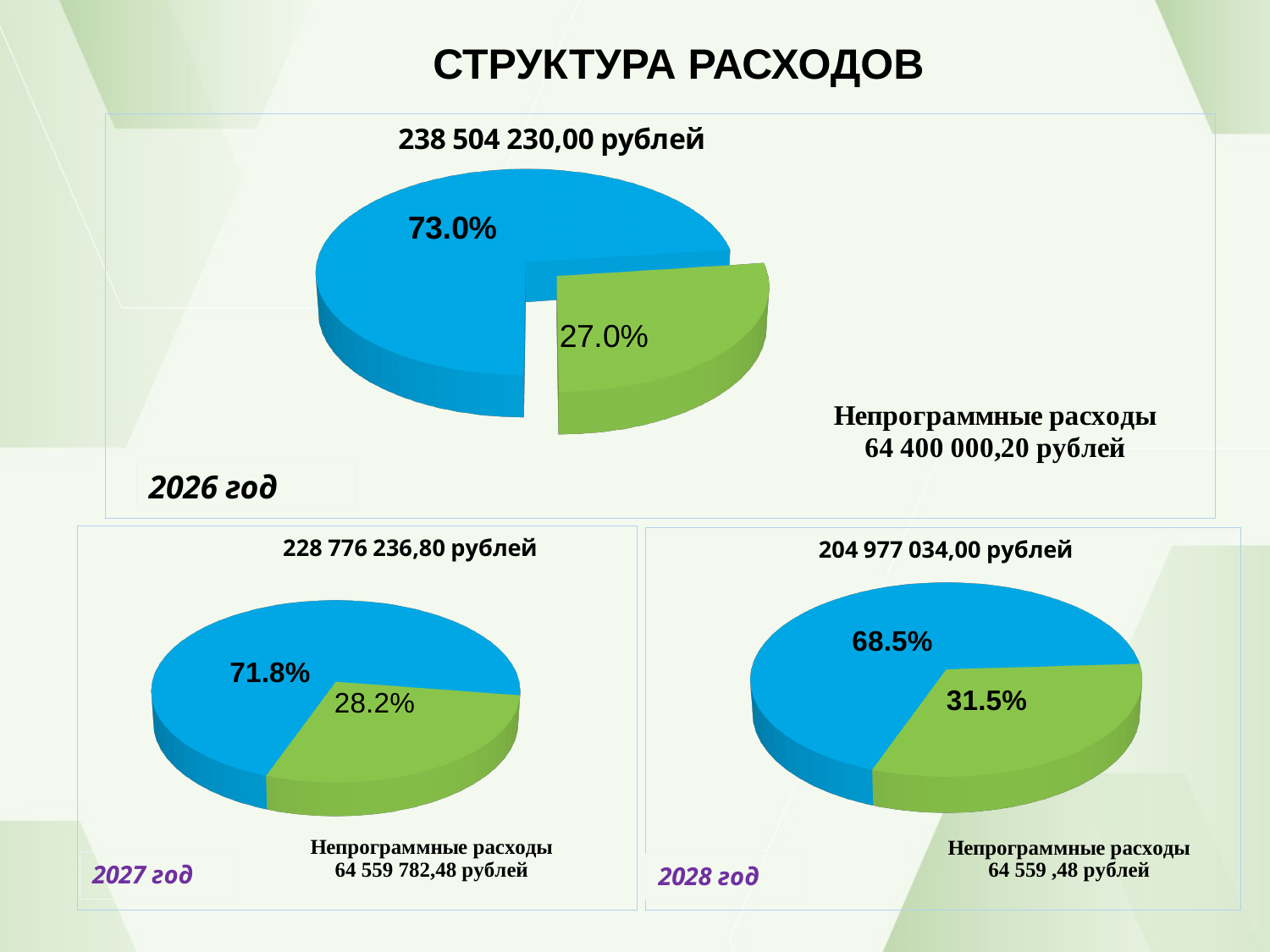
In the 2026 год pie chart, which slice is larger, the blue one or the green one? the blue one In the 2028 год pie chart, what is the difference between the blue slice and the green slice percentages? 37.0% What type of chart is used for the 2026 год data? pie chart In the 2026 год pie chart, what percentage does the green slice represent? 27.0% In the 2027 год pie chart, what percentage does the blue slice represent? 71.8% In the 2028 год pie chart, what percentage does the blue slice represent? 68.5% What total amount in rubles is shown as the title of the 2028 год pie chart? 204 977 034,00 рублей What total amount in rubles is shown as the title of the 2026 год pie chart? 238 504 230,00 рублей In the 2027 год pie chart, what percentage does the green slice represent? 28.2% How many slices does the 2027 год pie chart have? 2 In the 2028 год pie chart, what percentage does the green slice represent? 31.5% In the 2026 год pie chart, what percentage does the blue slice represent? 73.0%